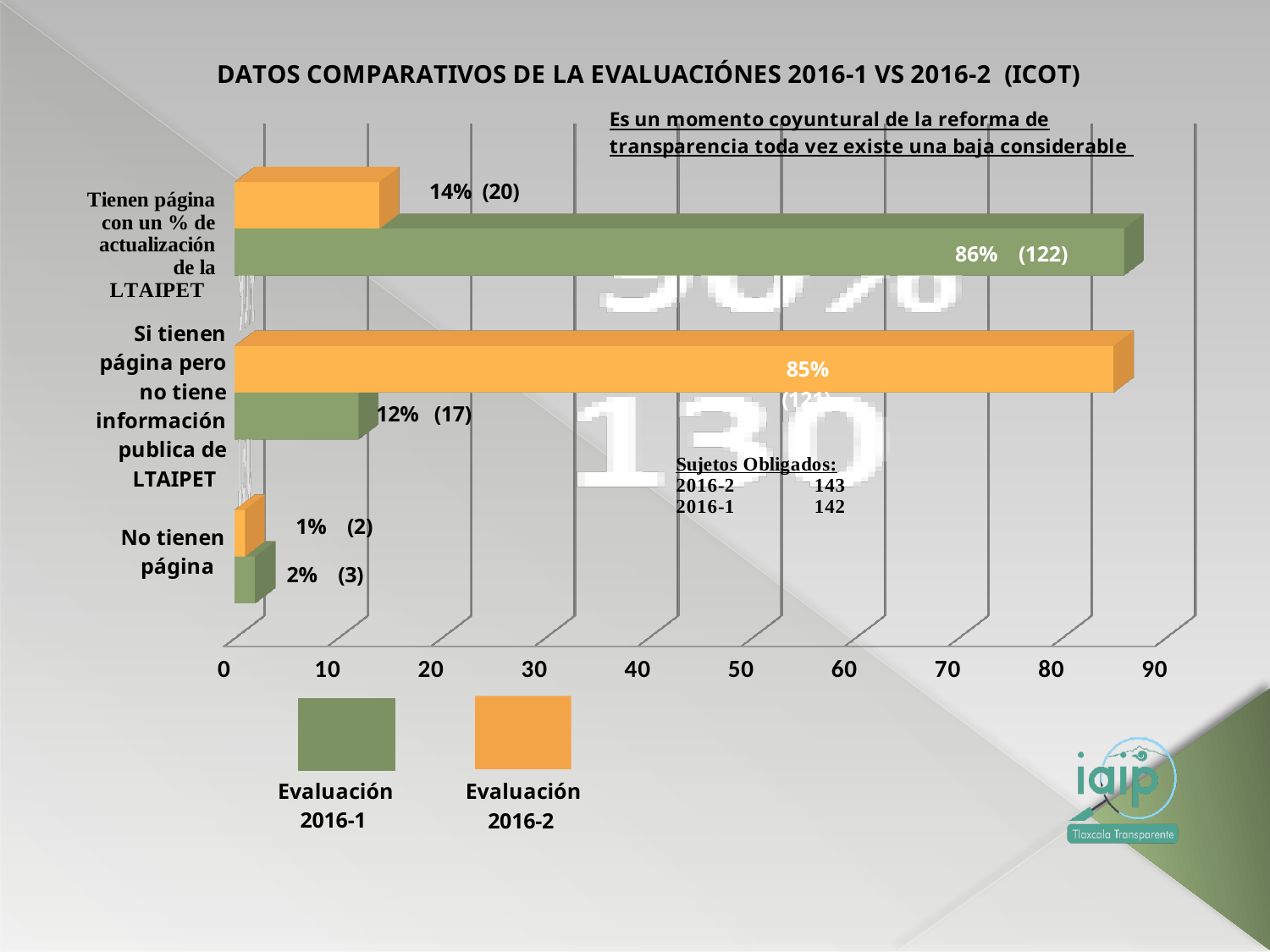
What kind of chart is shown on the slide? bar chart What is the difference in percentage points between Evaluación 2016-1 and Evaluación 2016-2 in the category 'Tienen página con un % de actualización de la LTAIPET'? 72 What is the value for Evaluación 2016-2 in the category 'No tienen página'? 1% (2) What is the value for Evaluación 2016-1 in the category 'Tienen página con un % de actualización de la LTAIPET'? 86% (122) Which category has the lowest value for Evaluación 2016-2? No tienen página What is the value for Evaluación 2016-1 in the category 'No tienen página'? 2% (3) How many series does the legend list? 2 What percentage is shown for Evaluación 2016-2 in the category 'Si tienen página pero no tiene información publica de LTAIPET'? 85% What is the value for Evaluación 2016-1 in the category 'Si tienen página pero no tiene información publica de LTAIPET'? 12% (17) What is the value for Evaluación 2016-2 in the category 'Tienen página con un % de actualización de la LTAIPET'? 14% (20) How many categories are plotted on the chart? 3 Which category has the highest value for Evaluación 2016-1? Tienen página con un % de actualización de la LTAIPET